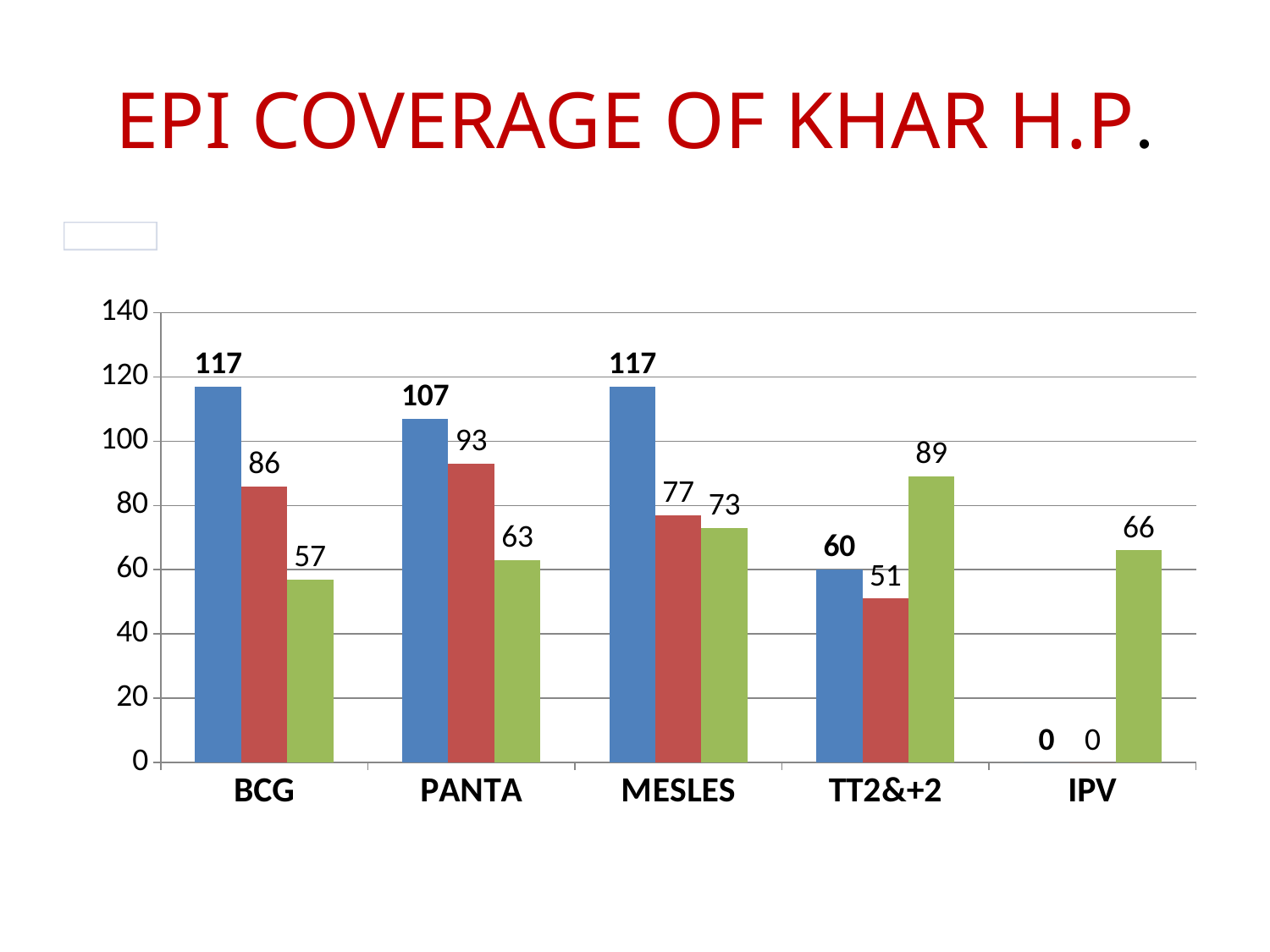
What is the value of the green bar for IPV? 66 Which category has the lowest red bar? IPV What is the value of the blue bar for BCG? 117 Which category has the highest green bar? TT2&+2 What is the difference between the blue bar and the green bar for BCG? 60 What is the value of the red bar for PANTA? 93 What kind of chart is shown on the slide? bar chart What is the value of the green bar for TT2&+2? 89 Which is larger for MESLES, the red bar or the green bar? the red bar How many categories are shown on the x axis? 5 What is the title of the slide? EPI COVERAGE OF KHAR H.P. Is the value of the blue bar for TT2&+2 greater or less than 80? less